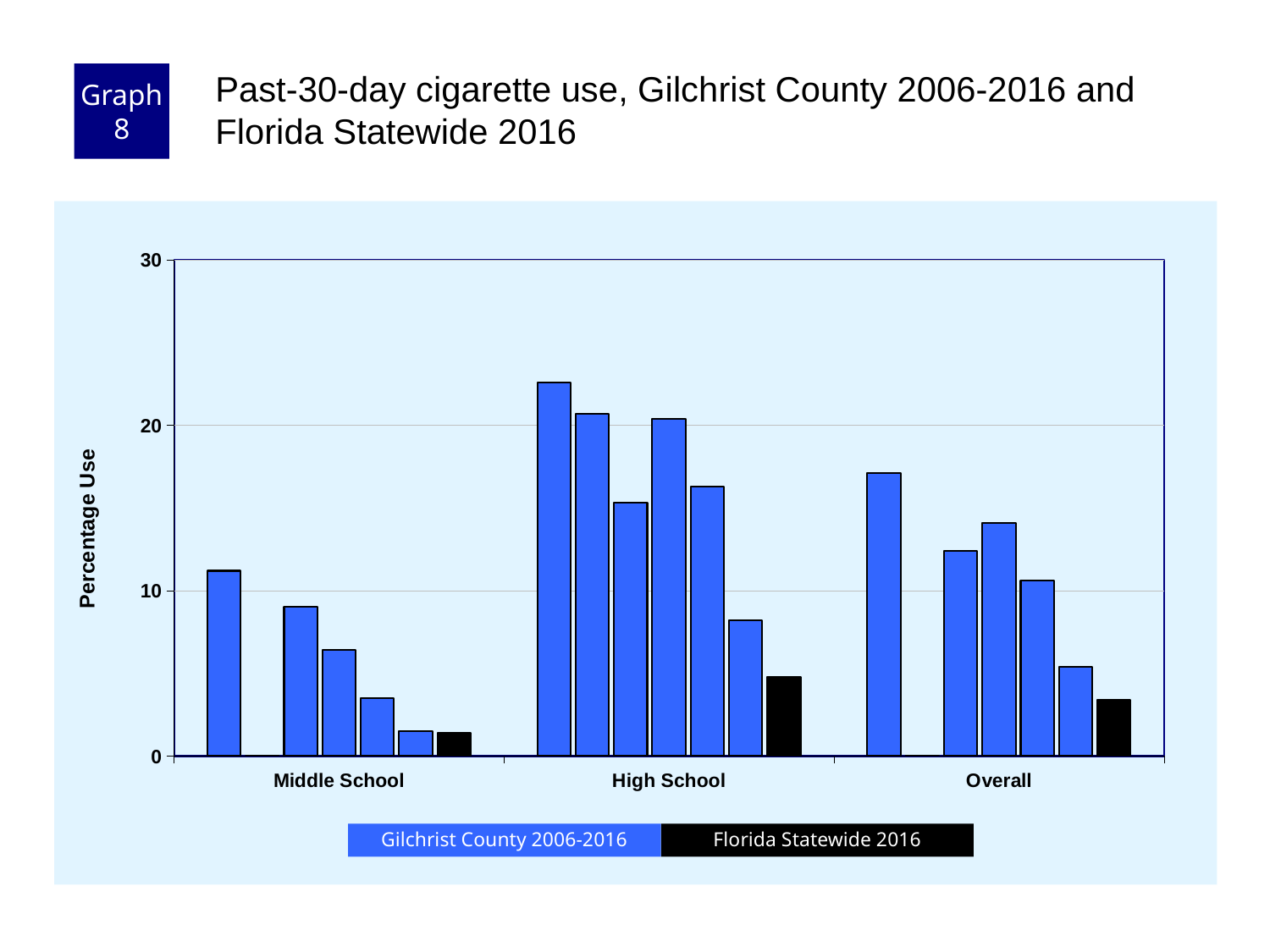
Is the tallest Gilchrist County 2006-2016 bar in the High School group greater or less than 20? greater Is the tallest Gilchrist County 2006-2016 bar in the Middle School group greater or less than 10? greater Is the Florida Statewide 2016 value larger for High School or for Middle School? High School How many categories are shown on the x axis? 3 What is the label on the y axis? Percentage Use Is the tallest Gilchrist County 2006-2016 bar in the Overall group greater or less than 20? less What kind of chart is shown on the slide? bar chart Which category has the lowest Florida Statewide 2016 bar? Middle School Do the Gilchrist County 2006-2016 bars in the Middle School group rise or fall from left to right? fall Which category has the tallest bar overall? High School How many series does the legend list? 2